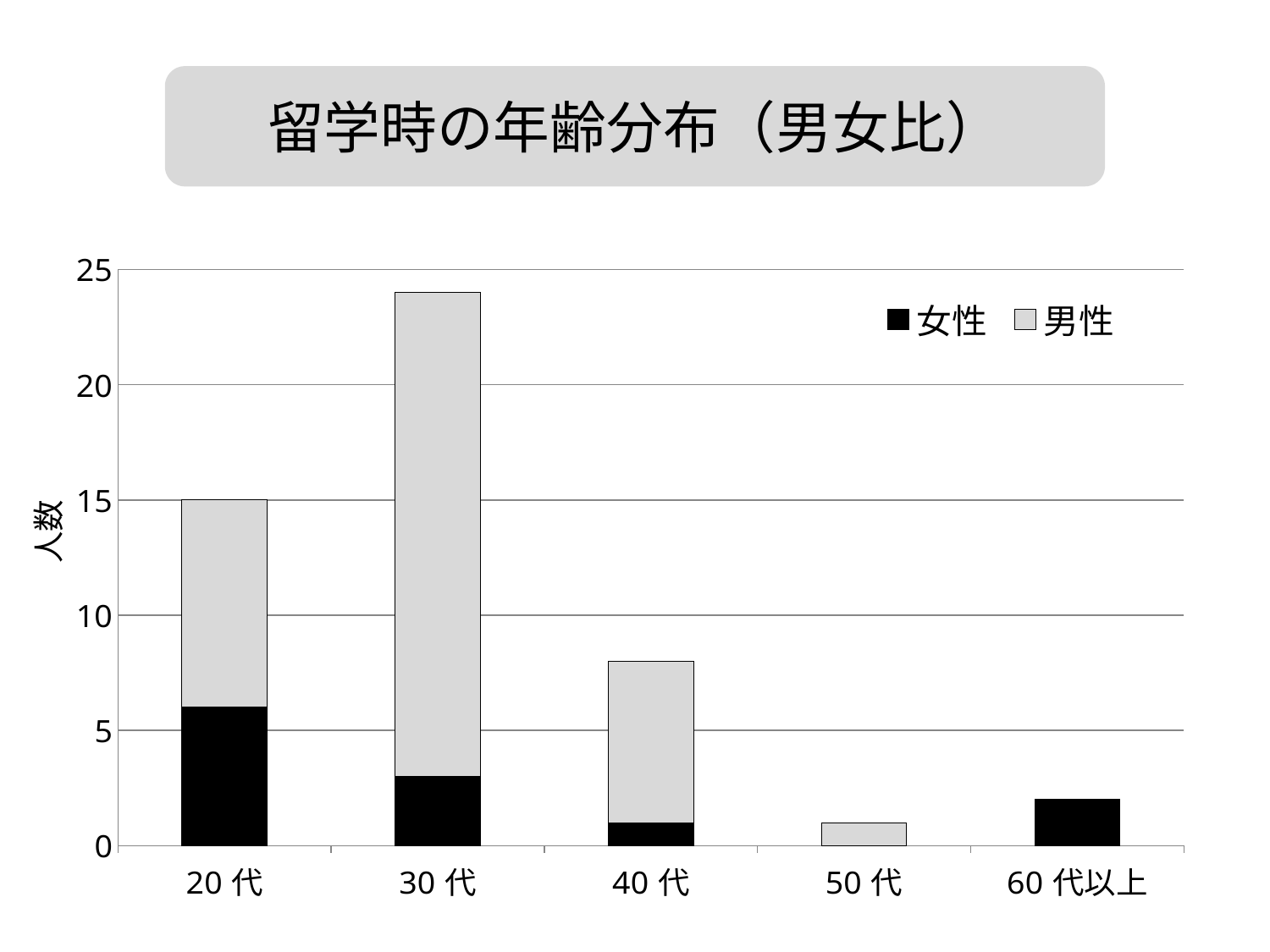
Is the total for 30代 greater or less than 20? greater Which is larger, the total for 20代 or the total for 40代? 20代 What is the total height of the stacked bar for 20代? 15 Which age group has the shortest stacked bar? 50代 Which age group has the tallest stacked bar? 30代 How many age categories are shown on the x axis? 5 Is the 女性 value for 20代 greater or less than 5? greater What kind of chart is shown on the slide? stacked bar chart Which age group has no 男性 segment in its bar? 60代以上 Is the total for 40代 greater or less than 10? less How many series does the legend list? 2 What is the title of the chart? 留学時の年齢分布（男女比）